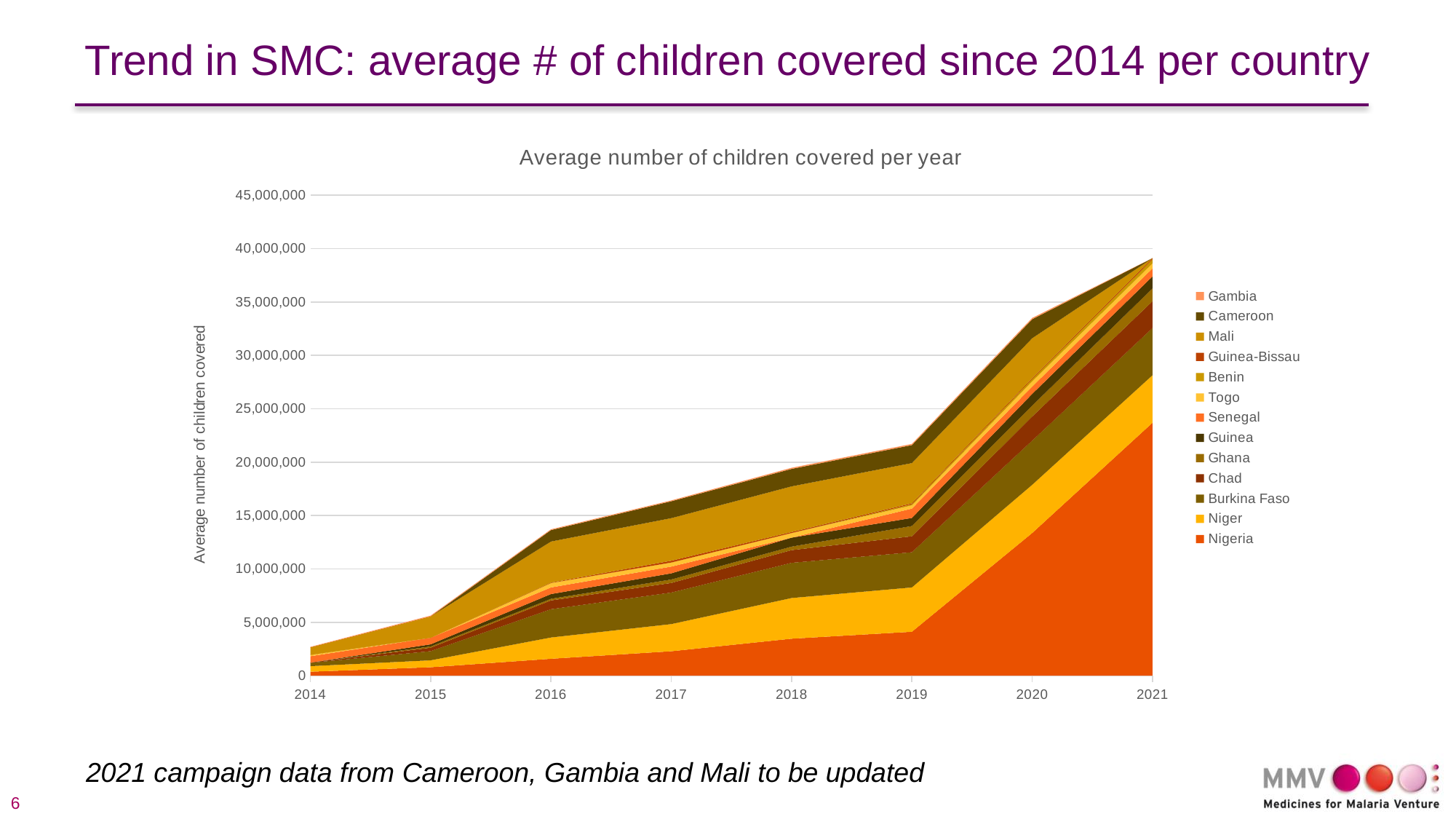
In which year is the total average number of children covered highest? 2021 What kind of chart is shown on the slide? Stacked area chart In which year is the total average number of children covered lowest? 2014 Is the total average number of children covered in 2014 greater or less than 5,000,000? less Is the total average number of children covered in 2021 greater or less than 35,000,000? greater Does the total average number of children covered rise or fall from 2014 to 2021? Rises How many years are plotted along the x axis of the chart? 8 Is the total average number of children covered in 2020 greater or less than 30,000,000? greater How many countries does the chart legend list? 13 Which country accounts for the largest number of children covered in 2021? Nigeria What is the title of the chart? Average number of children covered per year